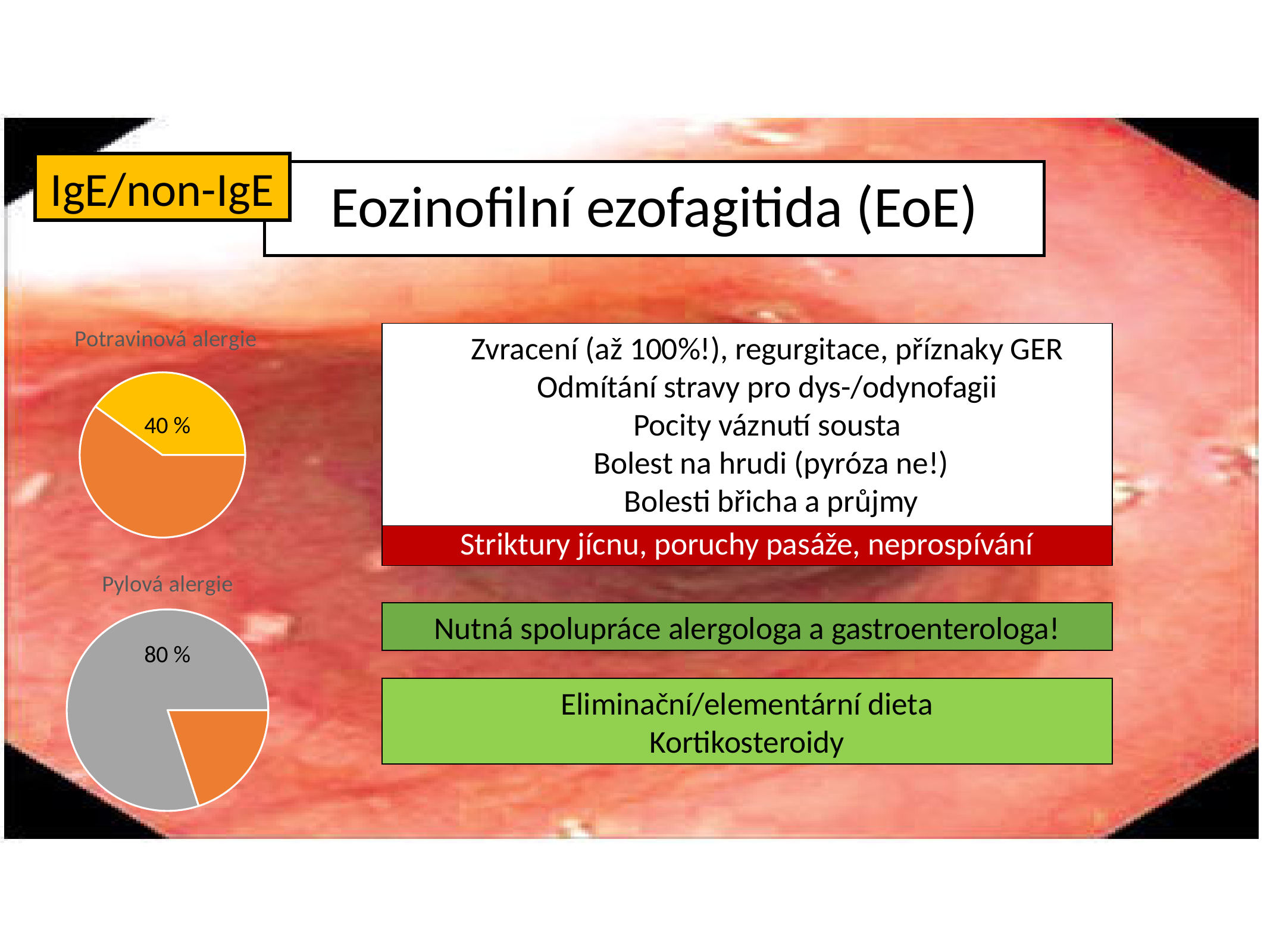
In the 'Pylová alergie' pie chart, what percentage is printed on the grey slice? 80 % What is the title of the lower pie chart on the left of the slide? Pylová alergie In the 'Pylová alergie' pie chart, which slice is larger, the grey one or the orange one? the grey one In the 'Pylová alergie' pie chart, what share of the pie does the grey slice represent? 80 % What is the title of the upper pie chart on the left of the slide? Potravinová alergie How many slices does the 'Potravinová alergie' pie chart have? 2 In the 'Potravinová alergie' pie chart, which slice is larger, the yellow one or the orange one? the orange one In the 'Potravinová alergie' pie chart, what share of the pie does the yellow slice represent? 40 % What kind of chart is the 'Potravinová alergie' chart? pie chart How many slices does the 'Pylová alergie' pie chart have? 2 What kind of chart is the 'Pylová alergie' chart? pie chart In the 'Potravinová alergie' pie chart, what percentage is printed on the yellow slice? 40 %